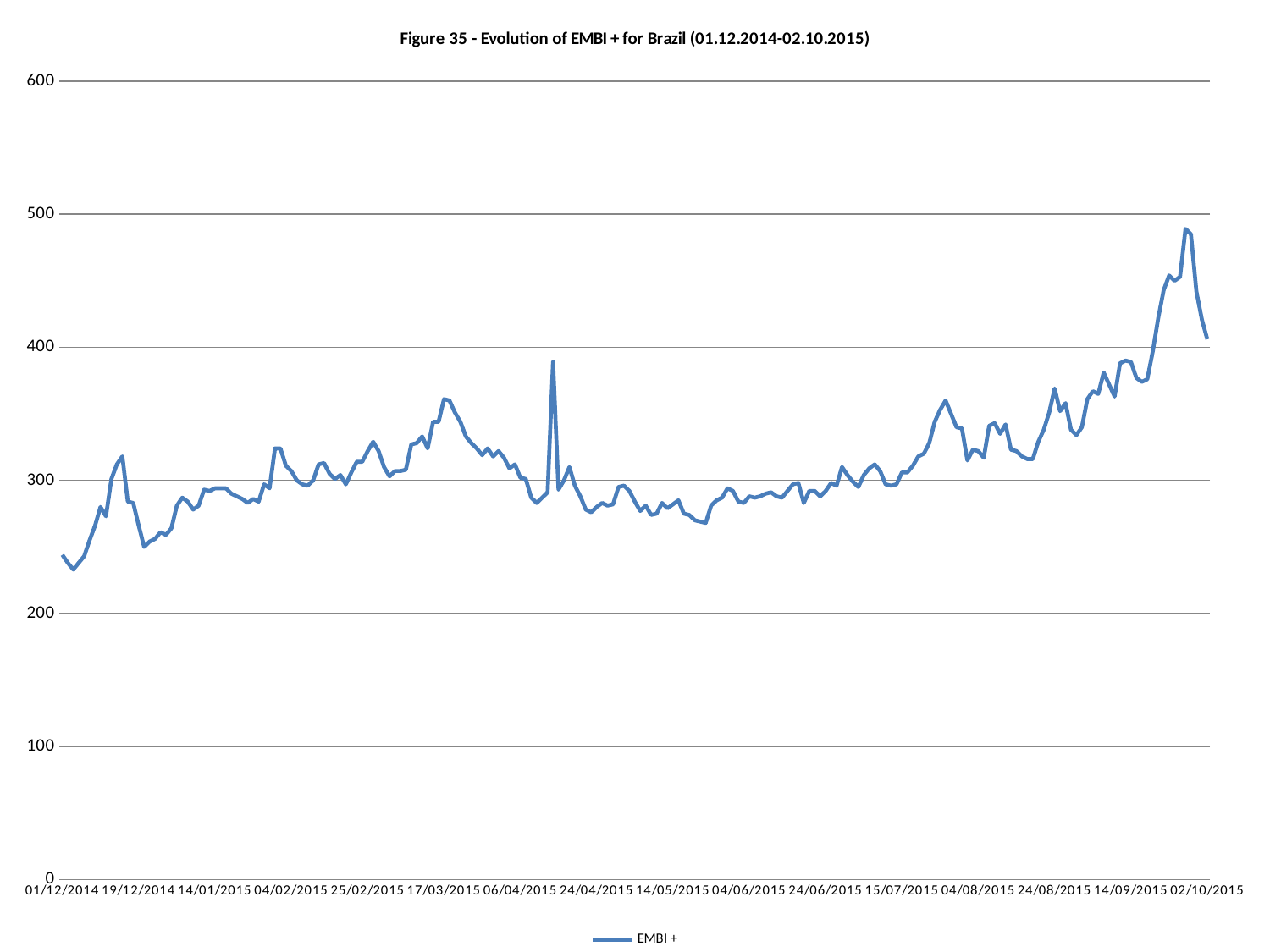
How many series does the legend list? 1 Overall, does the EMBI + value rise or fall from the start of the period to the end? rise Is the lowest value of EMBI + greater or less than 200? greater What is the name of the series shown in the legend? EMBI + Is the highest value reached by EMBI + greater or less than 500? less Is the value for EMBI + at 01/12/2014 greater or less than 300? less What kind of chart is shown on the slide? line chart Which is larger, the EMBI + value at 01/12/2014 or at 02/10/2015? 02/10/2015 What is the title of the chart? Figure 35 - Evolution of EMBI + for Brazil (01.12.2014-02.10.2015)